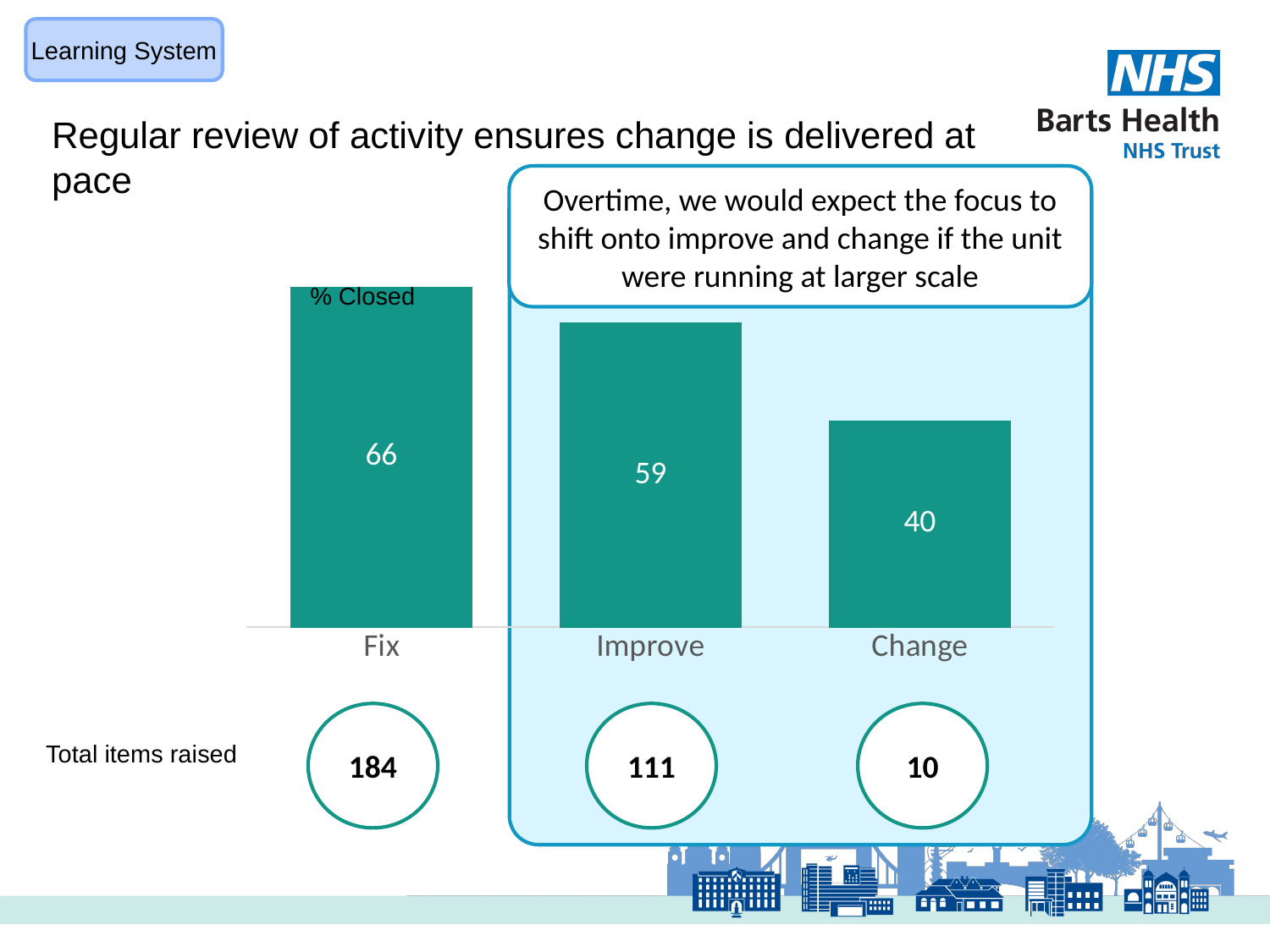
What is the difference between the % Closed values for Fix and Change? 26 What kind of chart is shown on the slide? Bar chart What is the difference between the % Closed values for Improve and Change? 19 Which category has the lowest % Closed value? Change How many categories are shown in the bar chart? 3 What is the % Closed value for Improve? 59 What is the % Closed value for Fix? 66 What is the % Closed value for Change? 40 Do the % Closed values rise or fall from Fix to Change along the x axis? Fall Which category has the highest % Closed value? Fix What label is shown at the top of the chart describing the plotted values? % Closed Which has a larger % Closed value, Fix or Improve? Fix